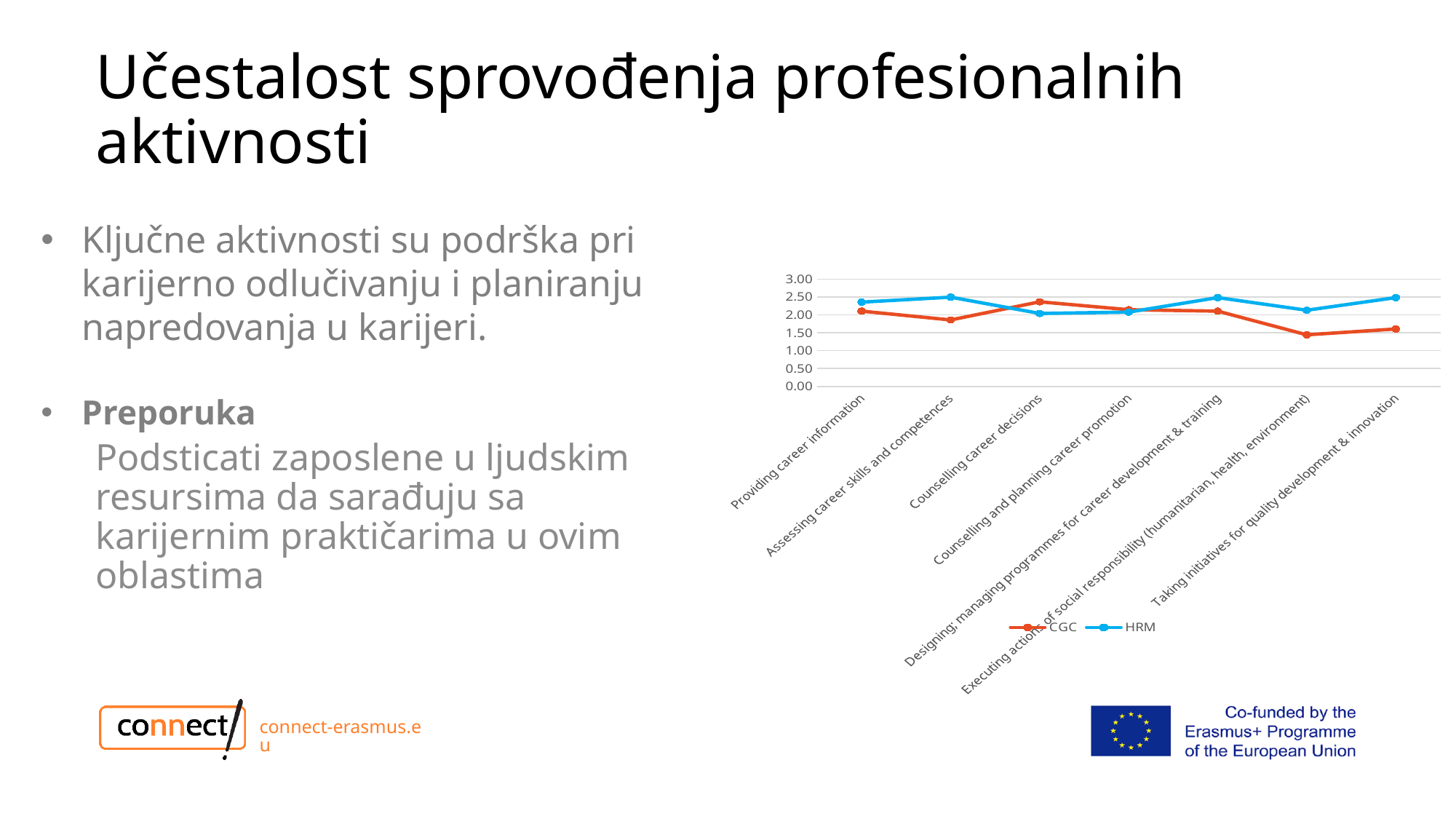
For 'Counselling career decisions', which series has the higher value, CGC or HRM? CGC For 'Taking initiatives for quality development & innovation', which series has the higher value, CGC or HRM? HRM Is the CGC value for 'Assessing career skills and competences' greater or less than 2.00? less How many categories are plotted along the x axis of the chart? 7 What kind of chart is shown on the slide? line chart For which category is the CGC value lowest? Executing actions of social responsibility (humanitarian, health, environment) Is the HRM value for 'Assessing career skills and competences' greater or less than 2.00? greater For which category is the CGC value highest? Counselling career decisions Is the CGC value for 'Executing actions of social responsibility (humanitarian, health, environment)' greater or less than 1.00? greater What colour is the HRM line in the chart? blue How many series does the chart's legend list? 2 Which two series are listed in the chart's legend? CGC and HRM